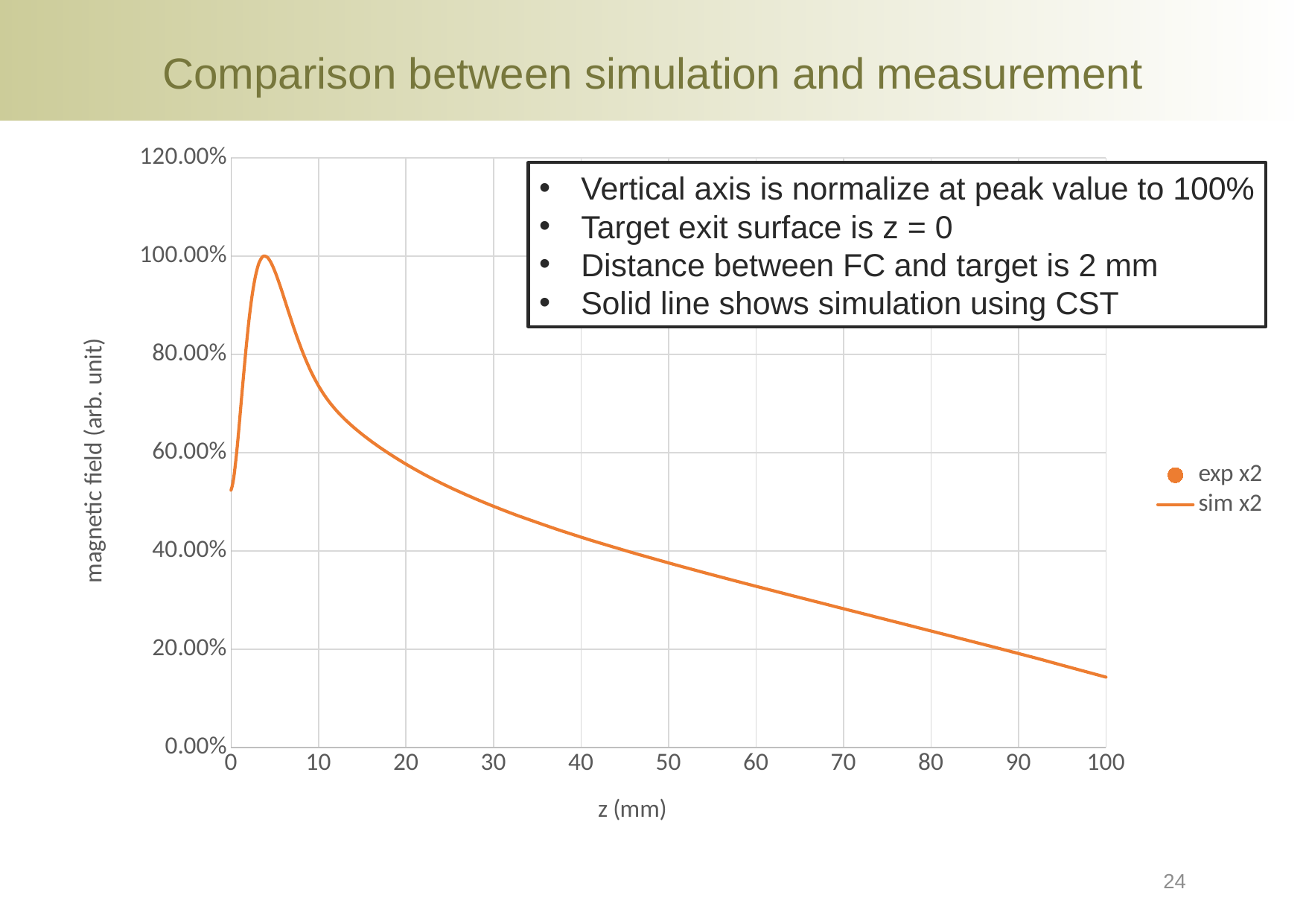
What kind of chart is shown on the slide? line chart What are the two series names listed in the chart legend? exp x2 and sim x2 How many series does the chart legend list? 2 Which is larger for the sim x2 curve: the value at z = 10 mm or the value at z = 90 mm? z = 10 mm After reaching its peak, does the sim x2 curve rise or fall as z increases toward 100 mm? fall What is the label of the vertical axis of the chart? magnetic field (arb. unit) Is the value of the sim x2 curve at z = 50 mm greater or less than 20%? greater Is the value of the sim x2 curve at z = 50 mm greater or less than 40%? less Is the value of the sim x2 curve at z = 20 mm greater or less than 40%? greater What is the peak value of the sim x2 curve on the vertical axis? 100.00%